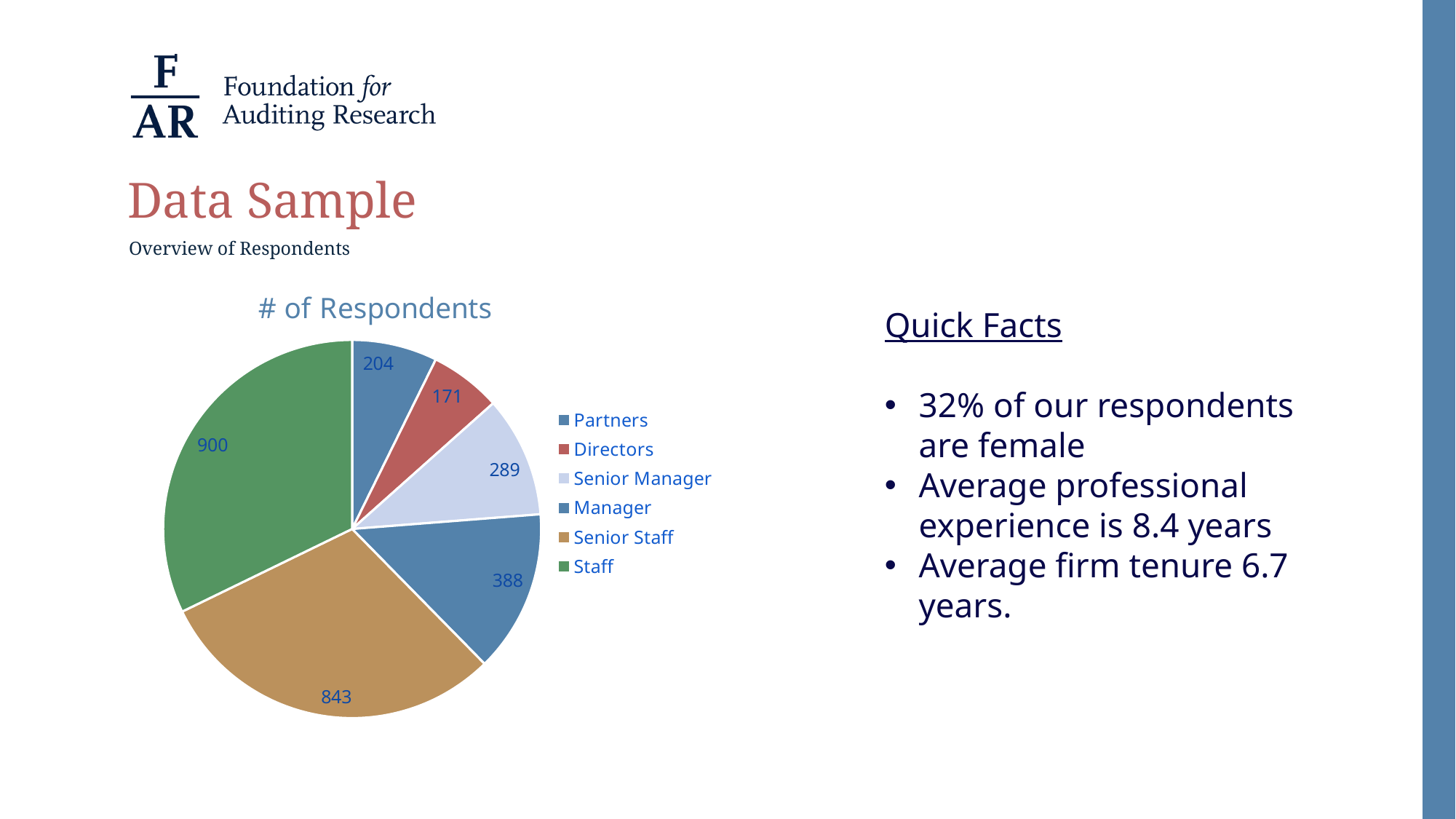
What is the difference between the number of Staff and Senior Staff respondents? 57 How many respondents are Managers? 388 How many respondents are Directors? 171 What type of chart is shown on the slide? pie chart What is the title of the chart? # of Respondents Which has more respondents, Manager or Senior Manager? Manager Which category has the smallest number of respondents? Directors Which category has the largest number of respondents? Staff How many categories does the pie chart show? 6 How many respondents are Senior Managers? 289 What is the total number of respondents across all slices of the pie chart? 2795 How many respondents are Partners? 204